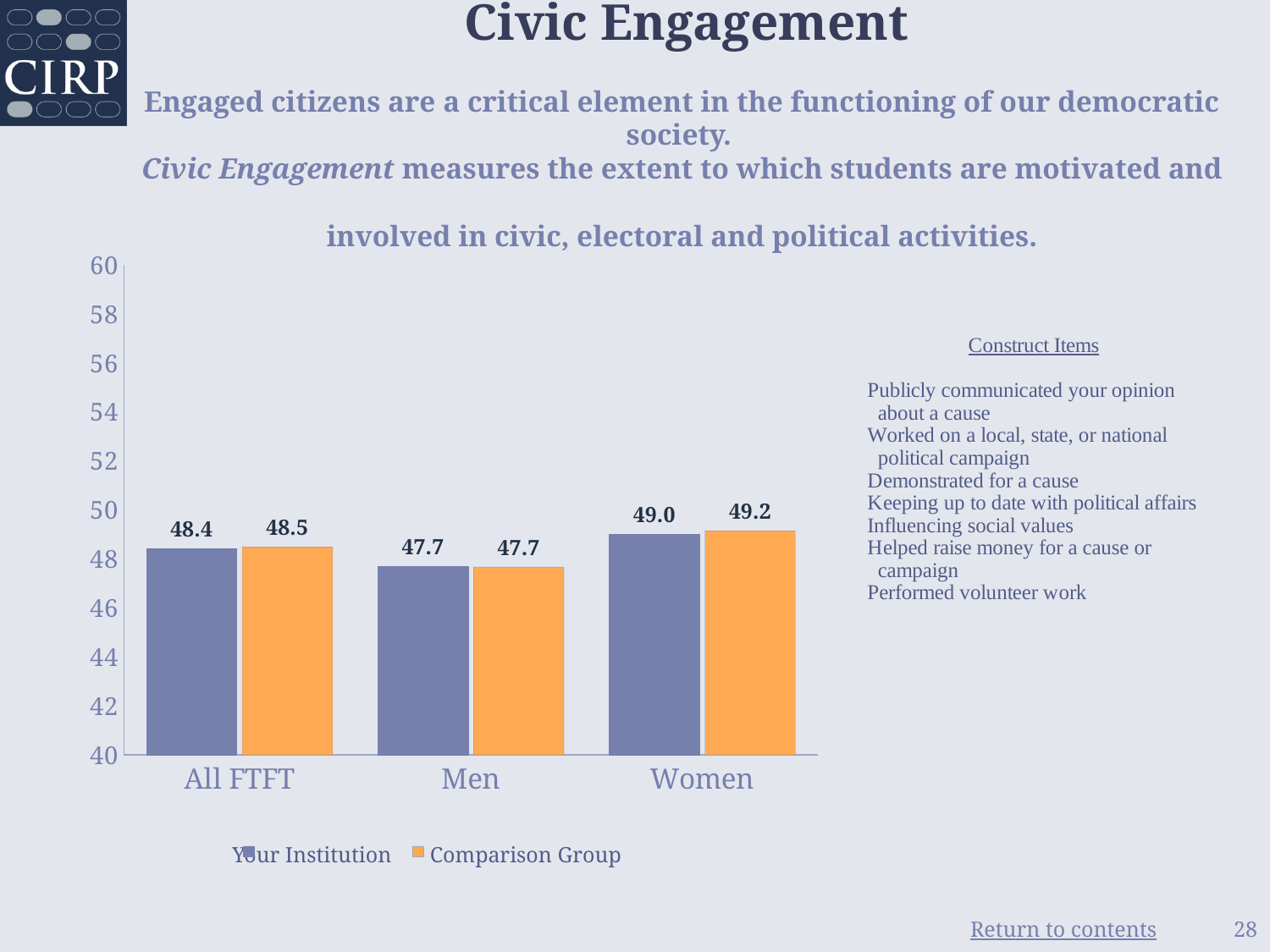
Which category has the lowest Comparison Group value? Men Which is larger for All FTFT: Your Institution or Comparison Group? Comparison Group What is the difference between the Comparison Group and Your Institution values for Women? 0.2 Which category has the highest Your Institution value? Women What is the difference between the Your Institution values for Women and Men? 1.3 What is the Comparison Group value for Women? 49.2 How many categories are shown on the x axis? 3 What is the Your Institution value for All FTFT? 48.4 How many series does the legend list? 2 What kind of chart is shown on the slide? bar chart What is the Your Institution value for Men? 47.7 Is the Your Institution value for Women greater or less than 48? greater